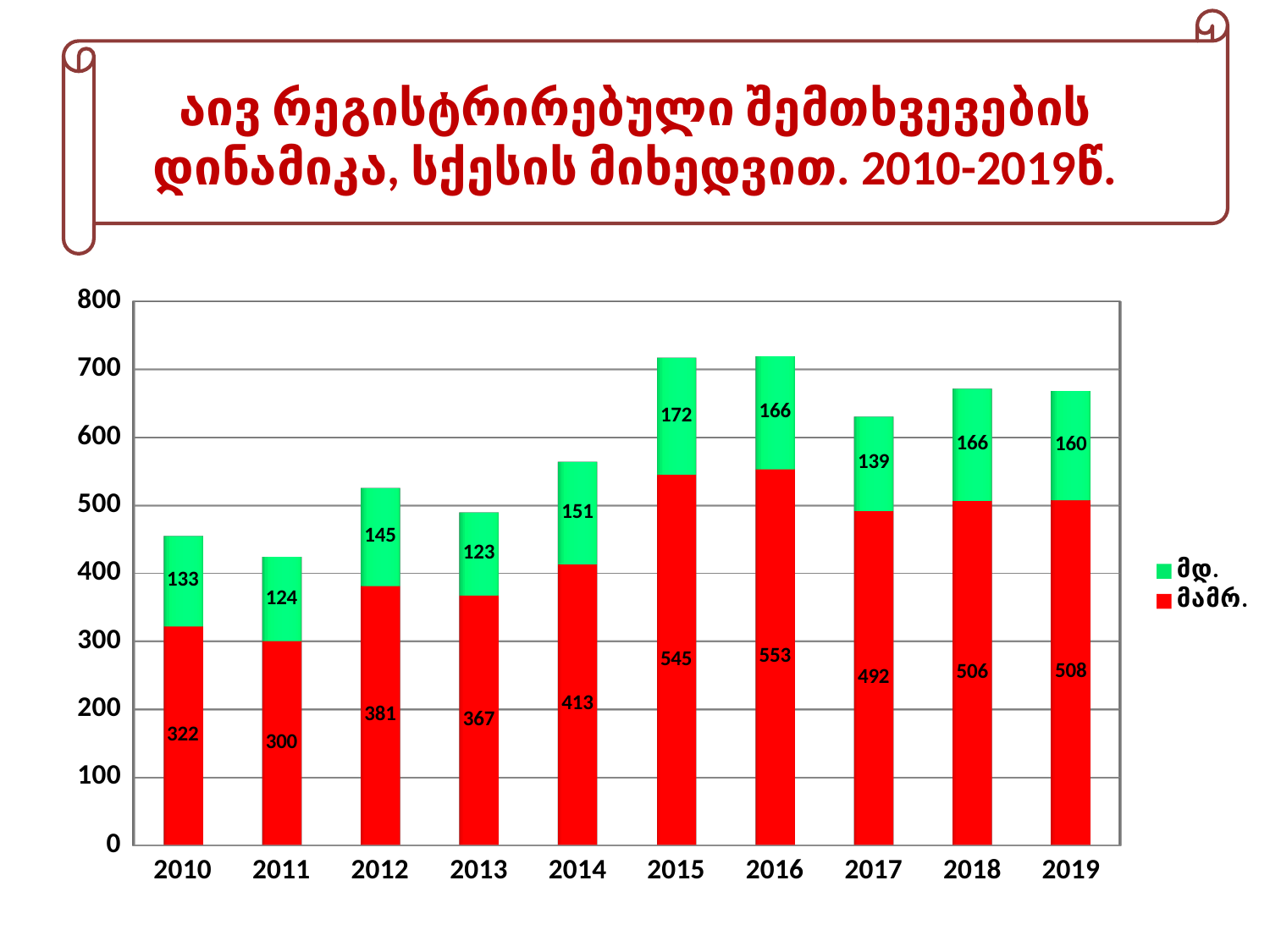
In which year is the მდ. value the lowest? 2013 What kind of chart is shown on the slide? Stacked bar chart What is the total of the stacked bar for 2011? 424 What is the value for მამრ. in 2010? 322 Which is larger, the მდ. value for 2012 or for 2017? 2012 What is the value for მამრ. in 2016? 553 How many series does the legend list? 2 What is the difference between the მამრ. values for 2015 and 2014? 132 In which year is the მამრ. value the highest? 2016 How many years are shown on the x axis? 10 What is the value for მდ. in 2013? 123 What is the total of the stacked bar for 2015? 717